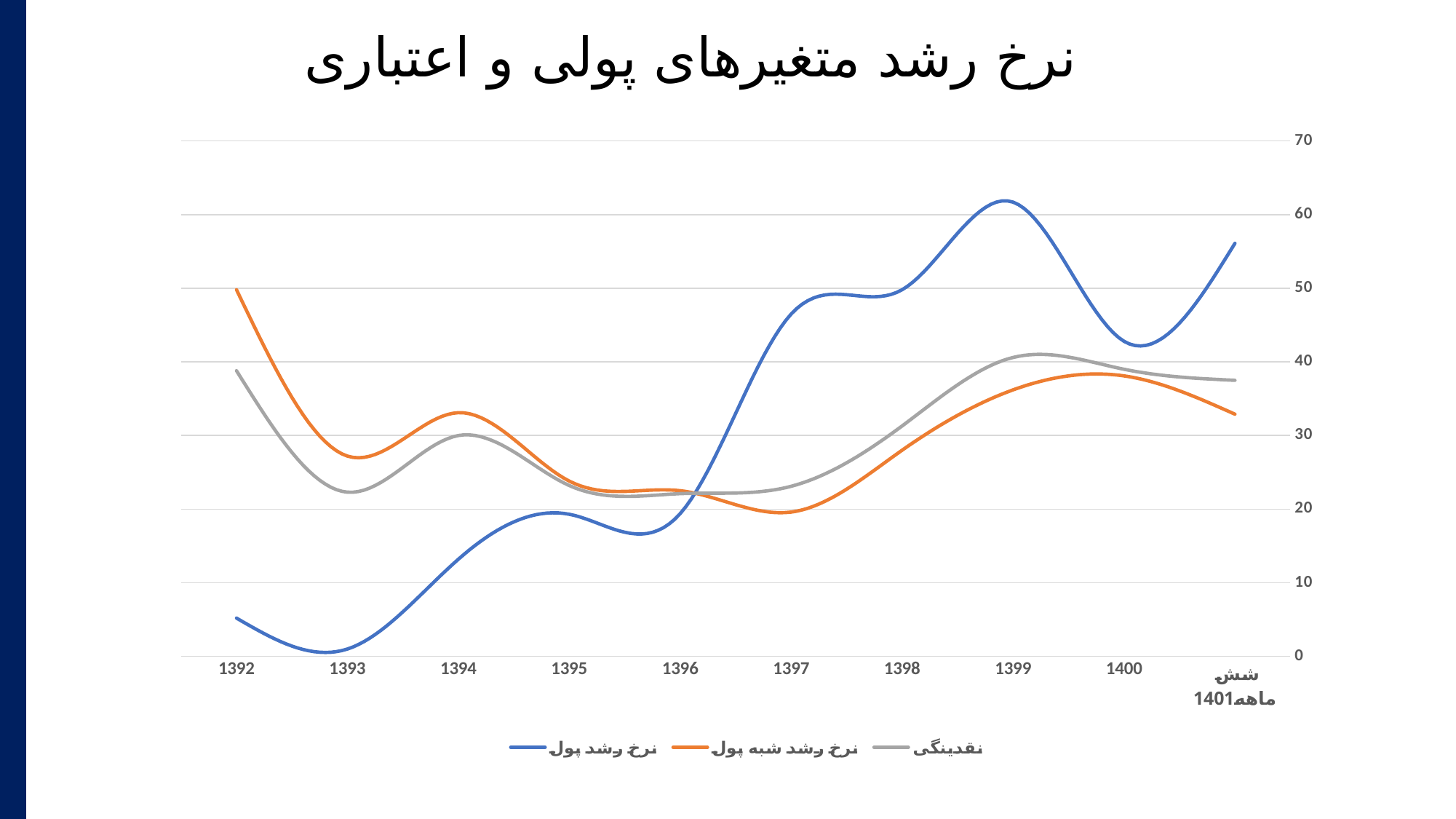
What is the title of the chart? نرخ رشد متغیرهای پولی و اعتباری Is the value of نرخ رشد پول in 1399 greater or less than 50? greater How many points are there along the x axis? 10 In 1392, which series has the higher value, نرخ رشد پول or نرخ رشد شبه پول? نرخ رشد شبه پول In which year does نرخ رشد پول reach its highest value? 1399 In which year does نرخ رشد پول reach its lowest value? 1393 How many series does the legend list? 3 What kind of chart is shown on the slide? line chart Is the value of نقدینگی in 1393 greater or less than 30? less Is the value of نرخ رشد پول in 1393 greater or less than 10? less In 1399, which series has the higher value, نرخ رشد پول or نقدینگی? نرخ رشد پول